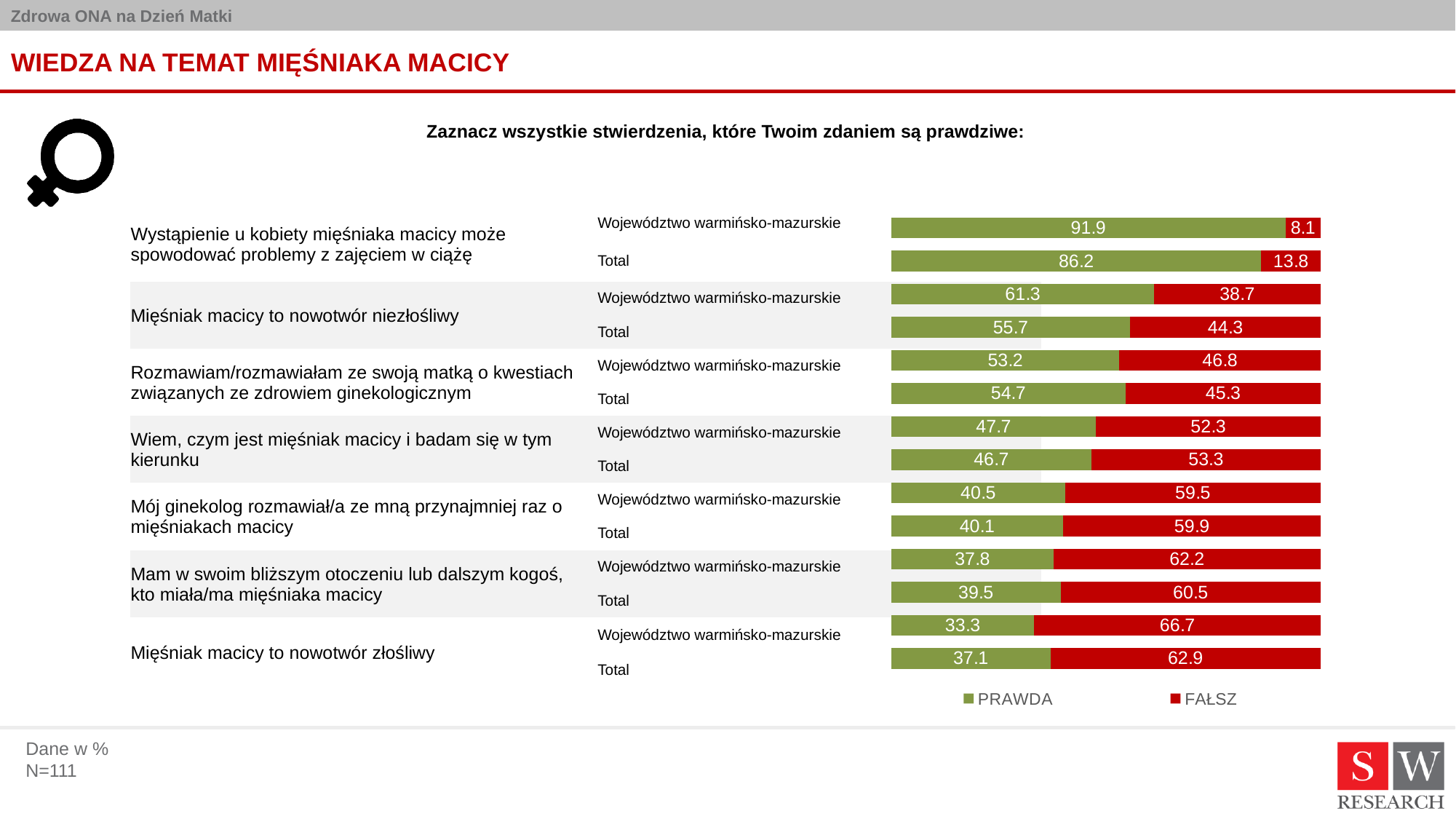
How many series does the legend list? 2 Which bar has the lowest PRAWDA value? Województwo warmińsko-mazurskie, Mięśniak macicy to nowotwór złośliwy What is the difference between the PRAWDA values for Województwo warmińsko-mazurskie and Total for the statement "Mięśniak macicy to nowotwór niezłośliwy"? 5.6 What is the FAŁSZ value for Total for the statement "Mięśniak macicy to nowotwór niezłośliwy"? 44.3 What is the total of the stacked bar for Total for the statement "Mój ginekolog rozmawiał/a ze mną przynajmniej raz o mięśniakach macicy"? 100 What is the PRAWDA value for Total for the statement "Mięśniak macicy to nowotwór złośliwy"? 37.1 Which bar has the highest PRAWDA value? Województwo warmińsko-mazurskie, Wystąpienie u kobiety mięśniaka macicy może spowodować problemy z zajęciem w ciążę What kind of chart is shown on the slide? Stacked bar chart What is the PRAWDA value for Województwo warmińsko-mazurskie for the statement "Wystąpienie u kobiety mięśniaka macicy może spowodować problemy z zajęciem w ciążę"? 91.9 For the statement "Mam w swoim bliższym otoczeniu lub dalszym kogoś, kto miała/ma mięśniaka macicy", which has the larger PRAWDA value: Województwo warmińsko-mazurskie or Total? Total How many statements are shown in the chart? 7 Which colour represents FAŁSZ in the chart? Red